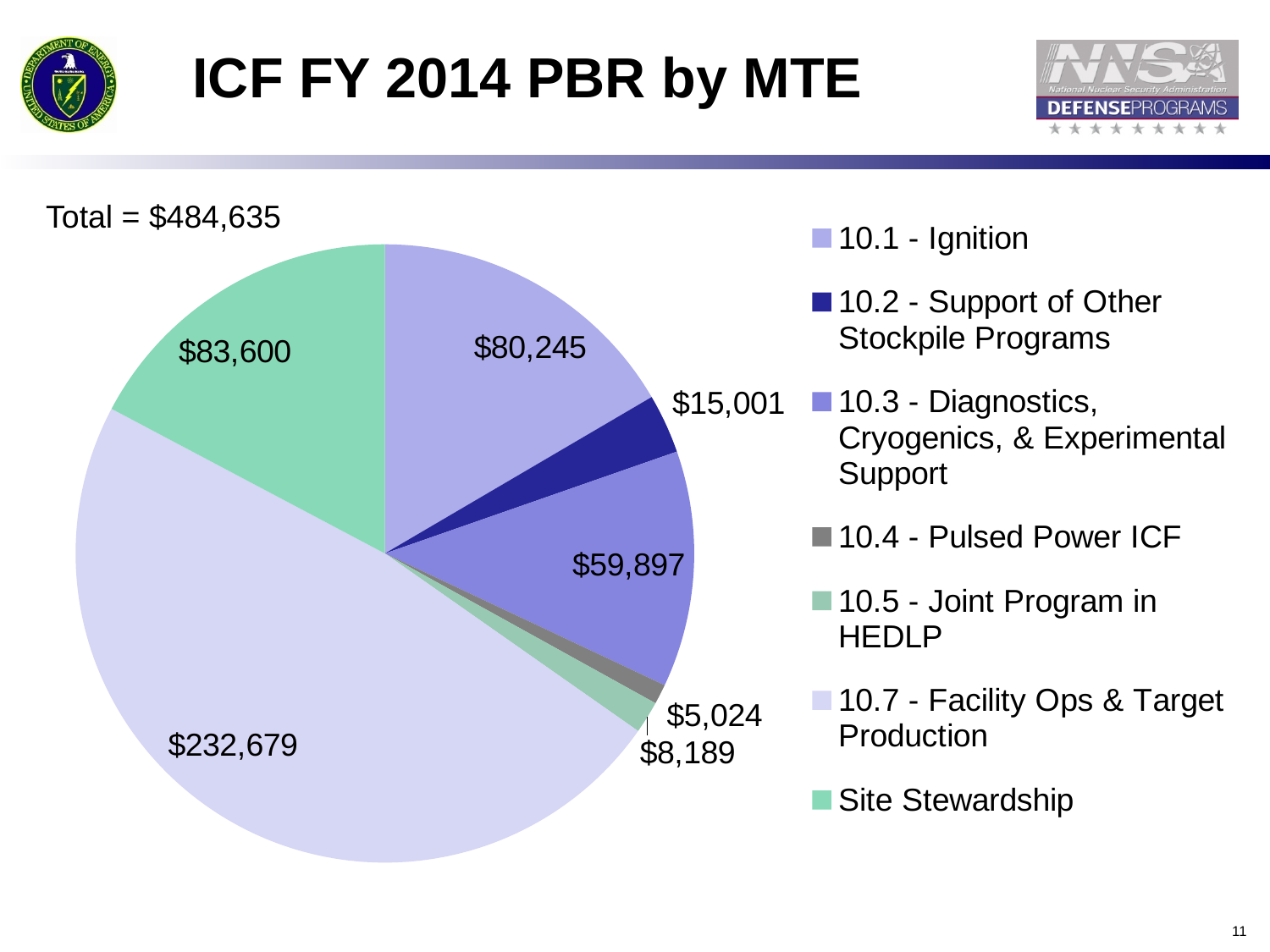
What total is stated on the slide for the pie chart? $484,635 Which is larger, the value for Site Stewardship or the value for 10.1 - Ignition? Site Stewardship What is the value for 10.1 - Ignition? $80,245 What is the value for 10.3 - Diagnostics, Cryogenics, & Experimental Support? $59,897 What kind of chart is shown on the slide? Pie chart What is the value for 10.7 - Facility Ops & Target Production? $232,679 Which category has the largest slice of the pie? 10.7 - Facility Ops & Target Production What is the value for 10.2 - Support of Other Stockpile Programs? $15,001 What is the difference between the values for Site Stewardship and 10.1 - Ignition? $3,355 How many categories does the legend list? 7 Which category has the smallest slice of the pie? 10.4 - Pulsed Power ICF What is the value for Site Stewardship? $83,600